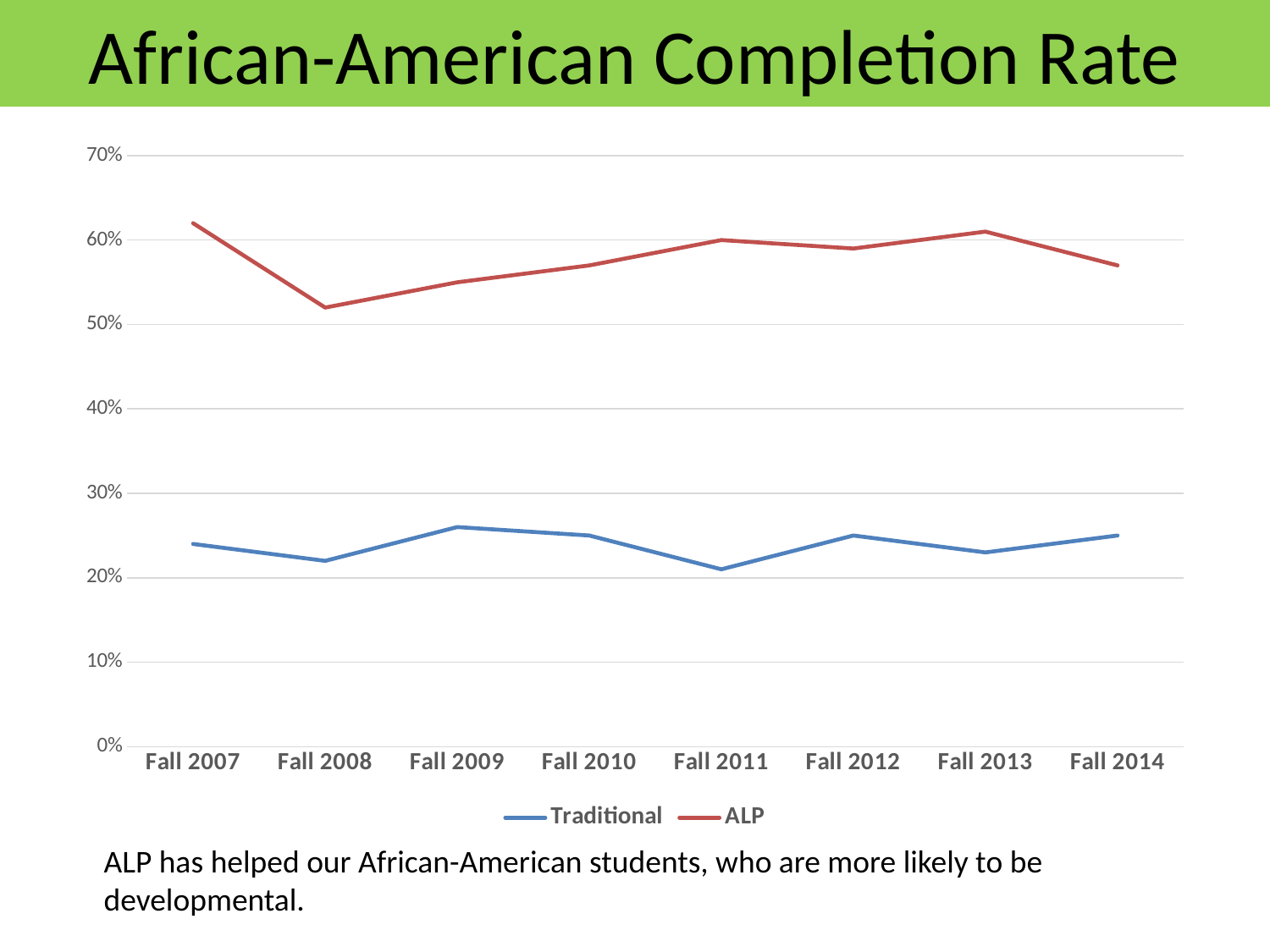
Which series has the higher value in Fall 2014, Traditional or ALP? ALP In which term is the Traditional completion rate lowest? Fall 2011 How many series does the legend list? 2 What is the title of the chart? African-American Completion Rate In which term is the ALP completion rate lowest? Fall 2008 Is the ALP value for Fall 2008 greater or less than 50%? greater Is the Traditional value for Fall 2011 greater or less than 30%? less Does the ALP line rise or fall from Fall 2007 to Fall 2008? fall Is the ALP value for Fall 2007 greater or less than 60%? greater How many time points are plotted along the x axis? 8 What kind of chart is shown on the slide? line chart